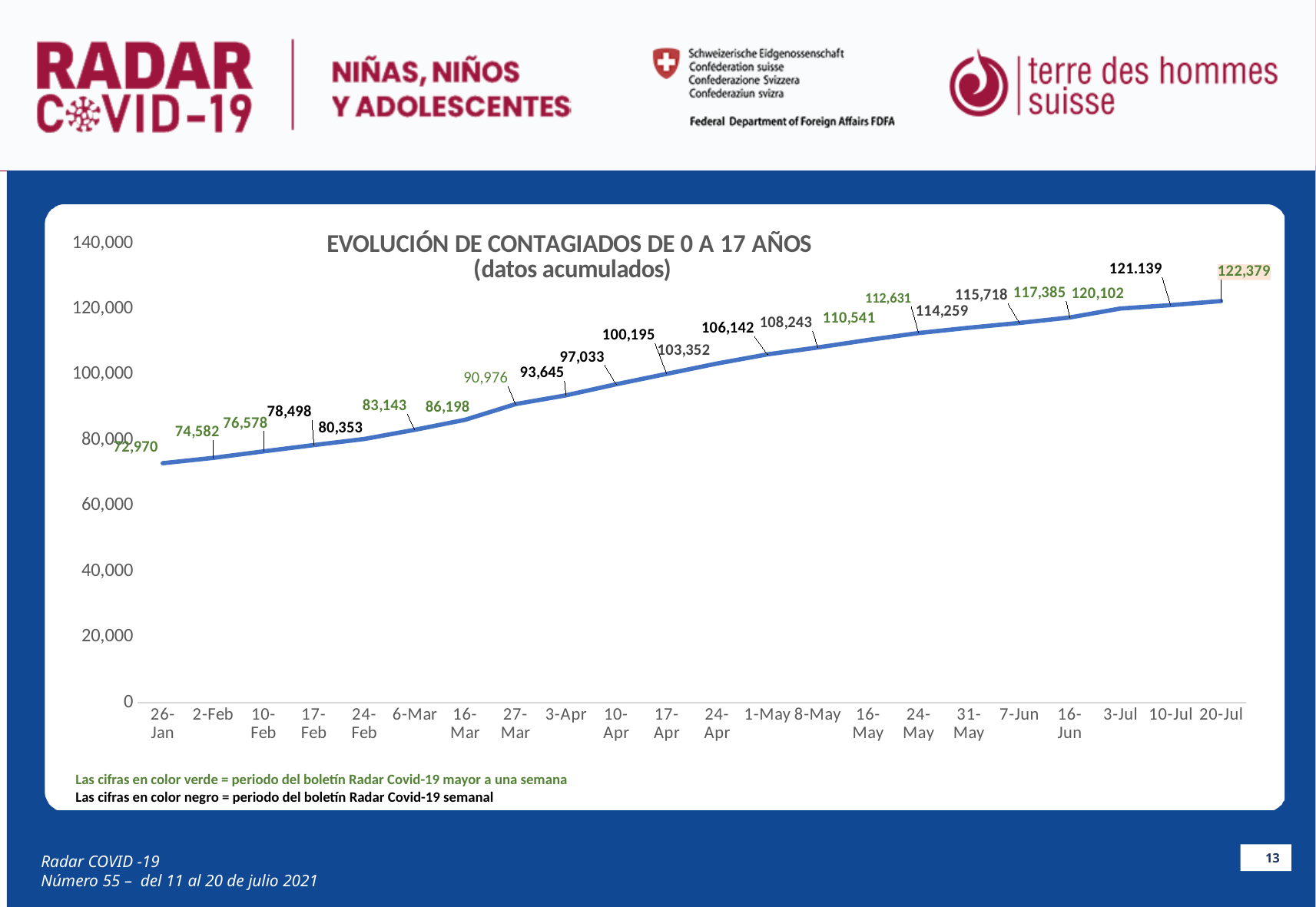
What is the difference between the values for 20-Jul and 26-Jan? 49,409 What is the value for 16-May? 110,541 Which date has the highest value? 20-Jul What is the value for 20-Jul? 122,379 Which date has the lowest value? 26-Jan What is the value for 26-Jan? 72,970 How many data points are plotted on the line? 22 Which is larger, the value for 24-Feb or the value for 6-Mar? 6-Mar Do the values rise or fall from 26-Jan to 20-Jul? Rise What is the value for 17-Apr? 100,195 What kind of chart is shown? Line chart What is the difference between the values for 3-Jul and 16-Jun? 2,717